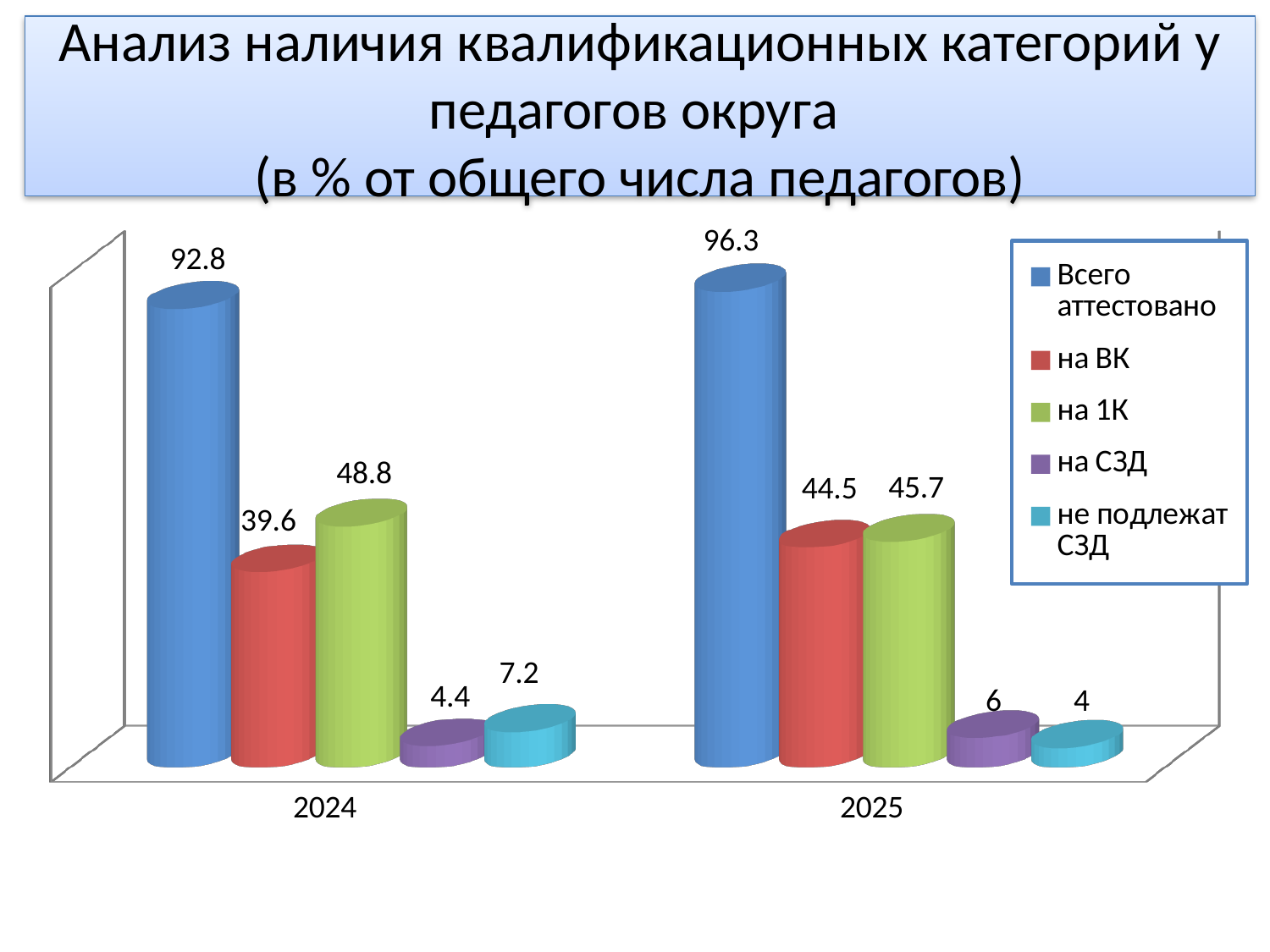
What is the value for "Всего аттестовано" in 2024? 92.8 What is the value for "не подлежат СЗД" in 2024? 7.2 What is the value for "на ВК" in 2025? 44.5 How many series does the legend list? 5 How many categories are shown on the x axis? 2 Which series has the lowest value in 2024? на СЗД What is the difference between "Всего аттестовано" in 2025 and in 2024? 3.5 Which series has the highest value in 2025? Всего аттестовано What kind of chart is shown on the slide? Bar chart Which is larger in 2024: "на ВК" or "на 1К"? на 1К What is the value for "на СЗД" in 2025? 6 Does the value for "на ВК" rise or fall from 2024 to 2025? Rise